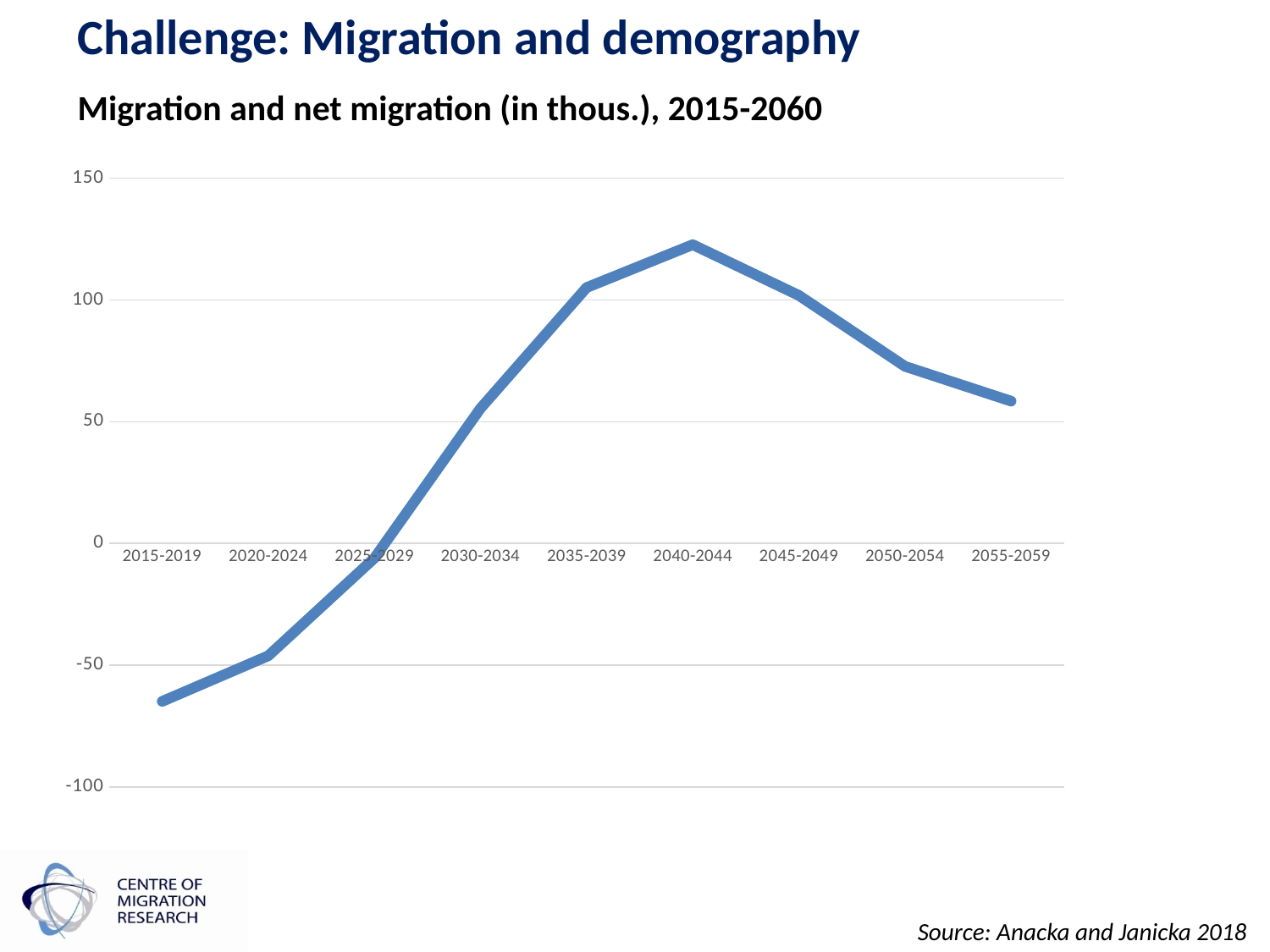
Is the value for 2040-2044 greater or less than 100? greater What is the title of the chart? Migration and net migration (in thous.), 2015-2060 Is the value for 2015-2019 greater or less than -50? less Which is larger, the value for 2035-2039 or the value for 2050-2054? 2035-2039 Which period has the highest value on the line? 2040-2044 Which period has the lowest value on the line? 2015-2019 Does the line rise or fall from 2015-2019 to 2040-2044? rise Is the value for 2030-2034 greater or less than 50? greater What kind of chart is shown on the slide? line chart Does the line rise or fall from 2040-2044 to 2055-2059? fall How many time periods are plotted along the x axis? 9